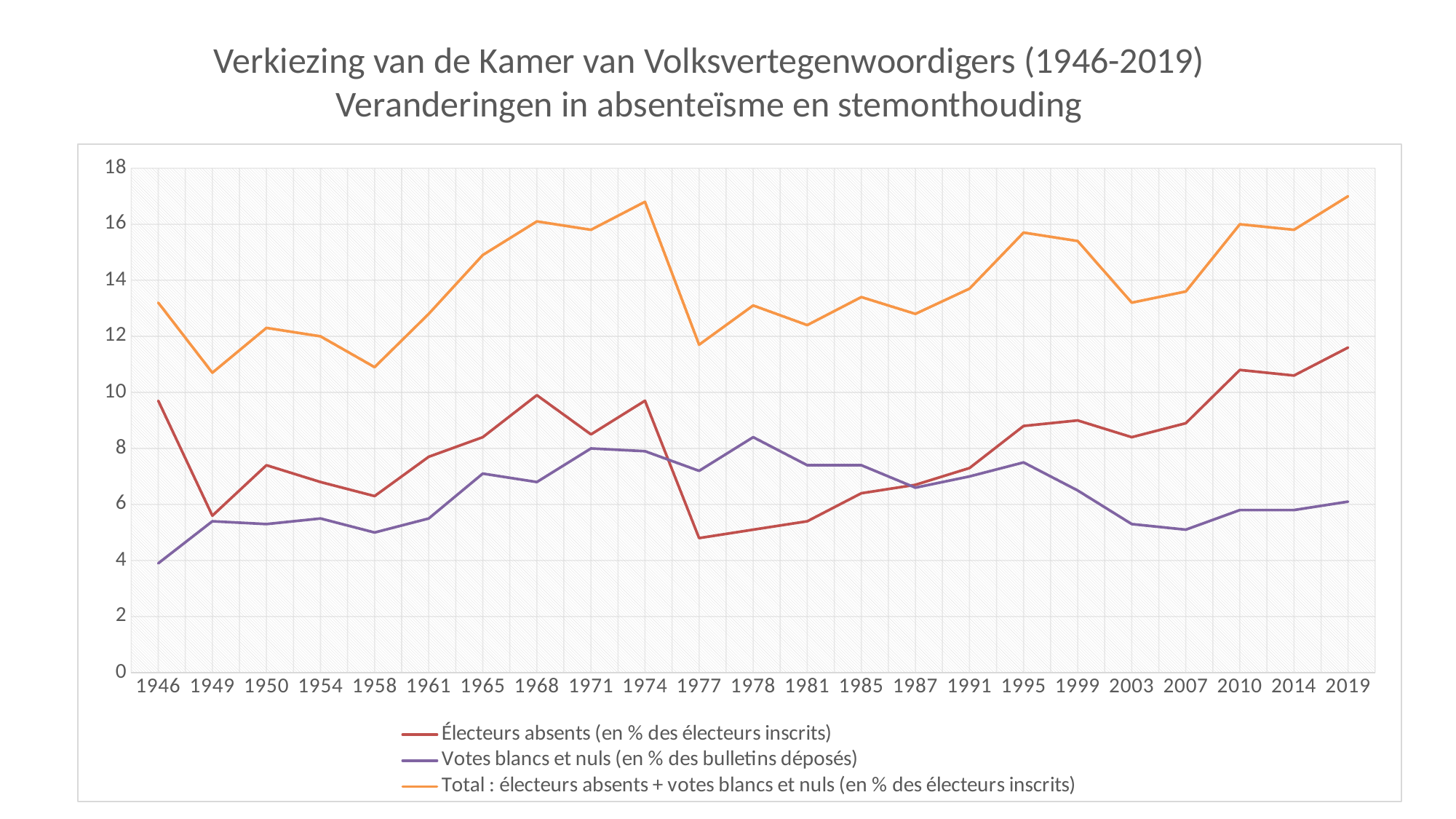
In which year is the value for 'Votes blancs et nuls' lowest? 1946 How many series does the legend list? 3 Is the value for 'Électeurs absents' in 1977 greater or less than 6? less Is the value for 'Votes blancs et nuls' in 1978 greater or less than 8? greater Does the 'Total' series rise or fall between 2003 and 2019? rise In which year is the value for 'Électeurs absents' highest? 2019 In 1978, which is larger: 'Électeurs absents' or 'Votes blancs et nuls'? Votes blancs et nuls In which year is the value for 'Électeurs absents' lowest? 1977 What colour is the line for the 'Total' series? orange How many election years are plotted along the x axis? 23 Is the value of the 'Total' series in 1974 greater or less than 16? greater What kind of chart is shown on the slide? line chart